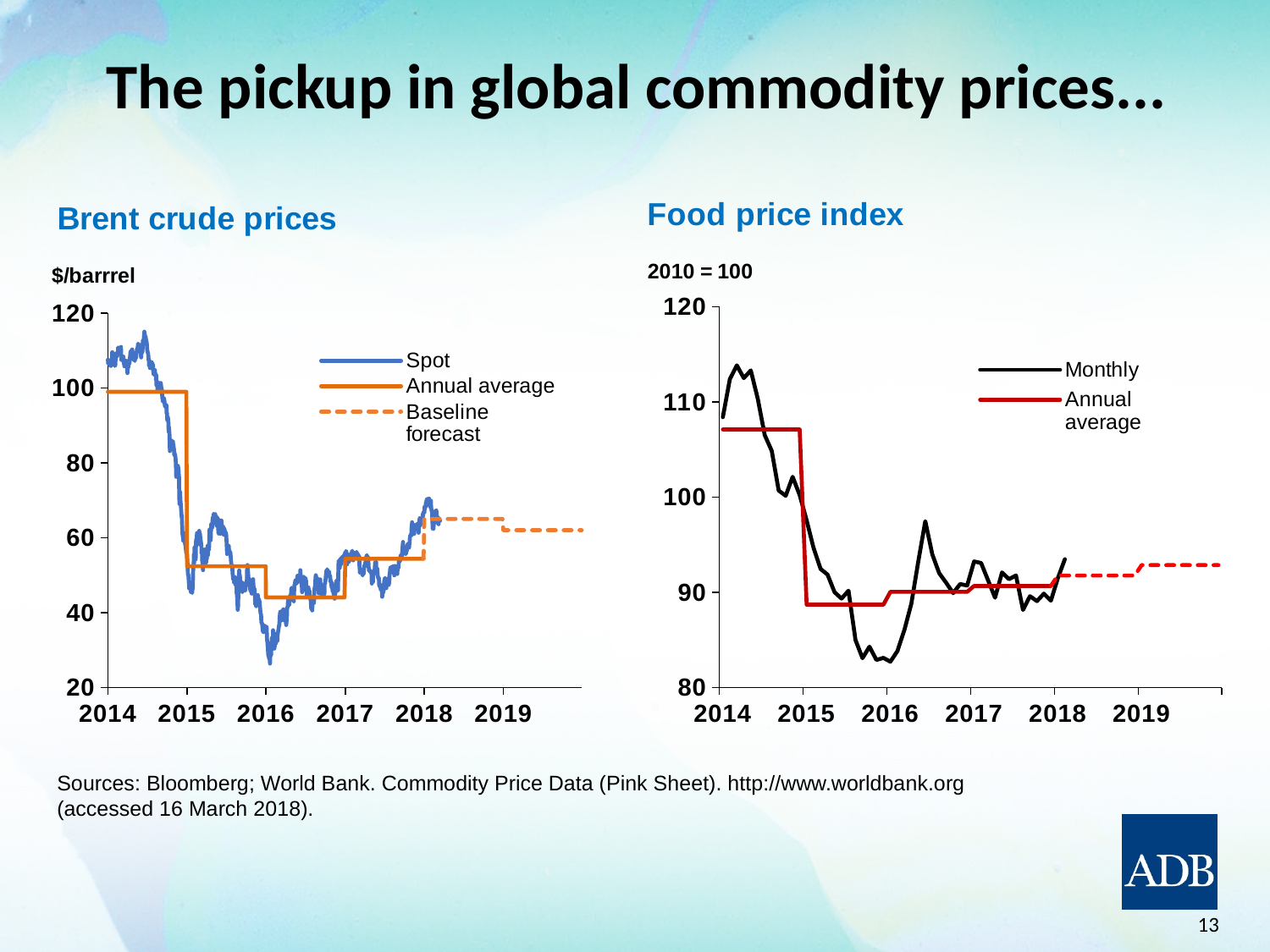
What kind of chart is the Brent crude prices chart? line chart How many series does the legend of the Food price index chart list? 2 In the Brent crude prices chart, is the Annual average value for 2015 greater or less than 40? greater In the Food price index chart, in which year is the Annual average highest? 2014 In the Food price index chart, what base is the index set to, as stated above the axis? 2010 = 100 How many series does the legend of the Brent crude prices chart list? 3 In the Brent crude prices chart, in which year is the Annual average lowest? 2016 In the Brent crude prices chart, is the Annual average value for 2016 greater or less than 60? less In the Brent crude prices chart, does the Annual average rise or fall from 2014 to 2016? fall In the Food price index chart, is the Annual average value for 2015 greater or less than 100? less In the Brent crude prices chart, which series is drawn as a dashed line? Baseline forecast